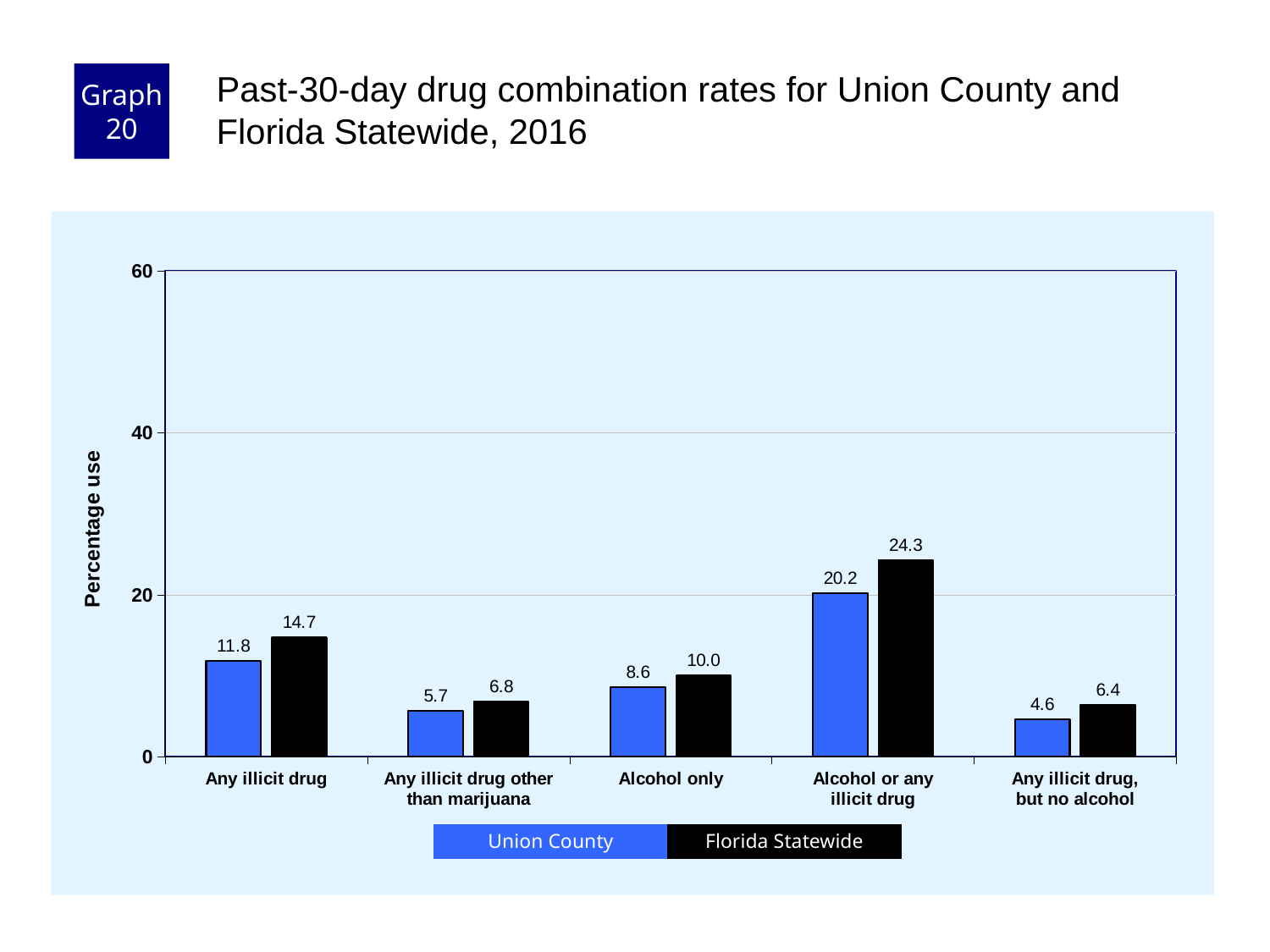
Which category has the highest Union County value? Alcohol or any illicit drug What is the difference between the Florida Statewide and Union County values for Any illicit drug? 2.9 What is the Union County value for Alcohol or any illicit drug? 20.2 What is the label of the y axis? Percentage use What kind of chart is shown on the slide? bar chart Is the Florida Statewide value for Alcohol or any illicit drug greater or less than 20? greater Which is larger for Alcohol or any illicit drug: Union County or Florida Statewide? Florida Statewide Which category has the lowest Florida Statewide value? Any illicit drug, but no alcohol What is the Florida Statewide value for Alcohol only? 10.0 How many categories are shown on the x axis? 5 How many series does the legend list? 2 What is the Florida Statewide value for Any illicit drug other than marijuana? 6.8